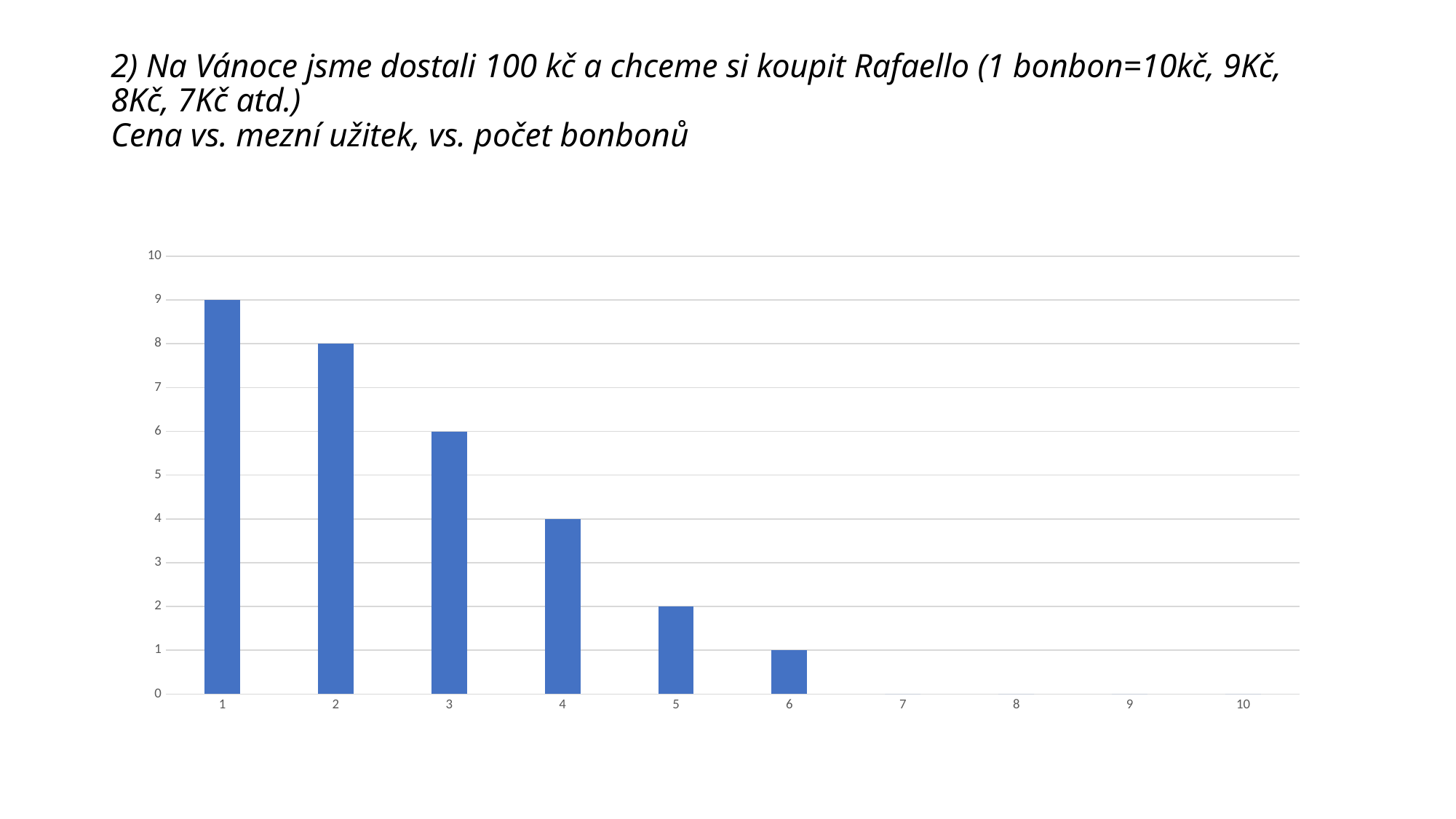
What is the value for category 5? 2 Which of the categories with a visible bar has the lowest value? 6 What is the value for category 3? 6 Which is larger, the value for category 2 or the value for category 3? category 2 Which category has the highest value? 1 What is the value for category 1? 9 How many categories are labelled on the x axis? 10 What kind of chart is shown on the slide? bar chart Do the bar values rise or fall as the category number increases along the x axis? fall What is the difference between the values for category 2 and category 4? 4 Is the value for category 4 greater or less than 5? less What is the value for category 6? 1